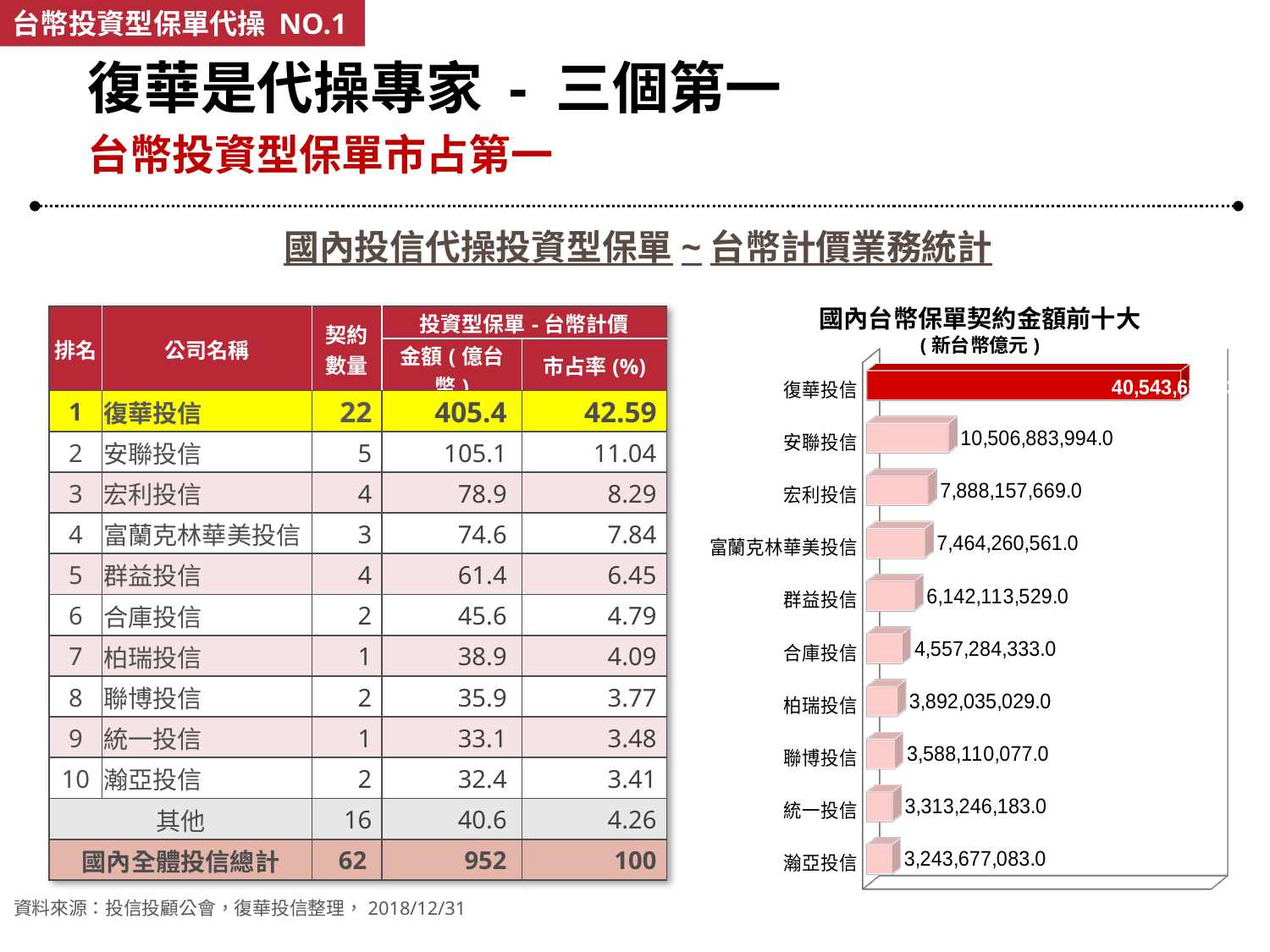
In the chart 國內台幣保單契約金額前十大, what is the value for 宏利投信? 7,888,157,669.0 In the chart 國內台幣保單契約金額前十大, which is larger, the value for 合庫投信 or the value for 聯博投信? 合庫投信 In the chart 國內台幣保單契約金額前十大, what colour is the bar for 復華投信? red What kind of chart is shown on the right side of the slide? bar chart In the chart 國內台幣保單契約金額前十大, what is the value for 瀚亞投信? 3,243,677,083.0 In the chart 國內台幣保單契約金額前十大, what is the value for 柏瑞投信? 3,892,035,029.0 In the chart 國內台幣保單契約金額前十大, which company has the lowest value? 瀚亞投信 In the chart 國內台幣保單契約金額前十大, which company has the highest value? 復華投信 In the chart 國內台幣保單契約金額前十大, how many companies are shown? 10 In the chart 國內台幣保單契約金額前十大, what is the value for 安聯投信? 10,506,883,994.0 In the chart 國內台幣保單契約金額前十大, what is the value for 群益投信? 6,142,113,529.0 In the chart 國內台幣保單契約金額前十大, what is the difference between the values for 安聯投信 and 宏利投信? 2,618,726,325.0